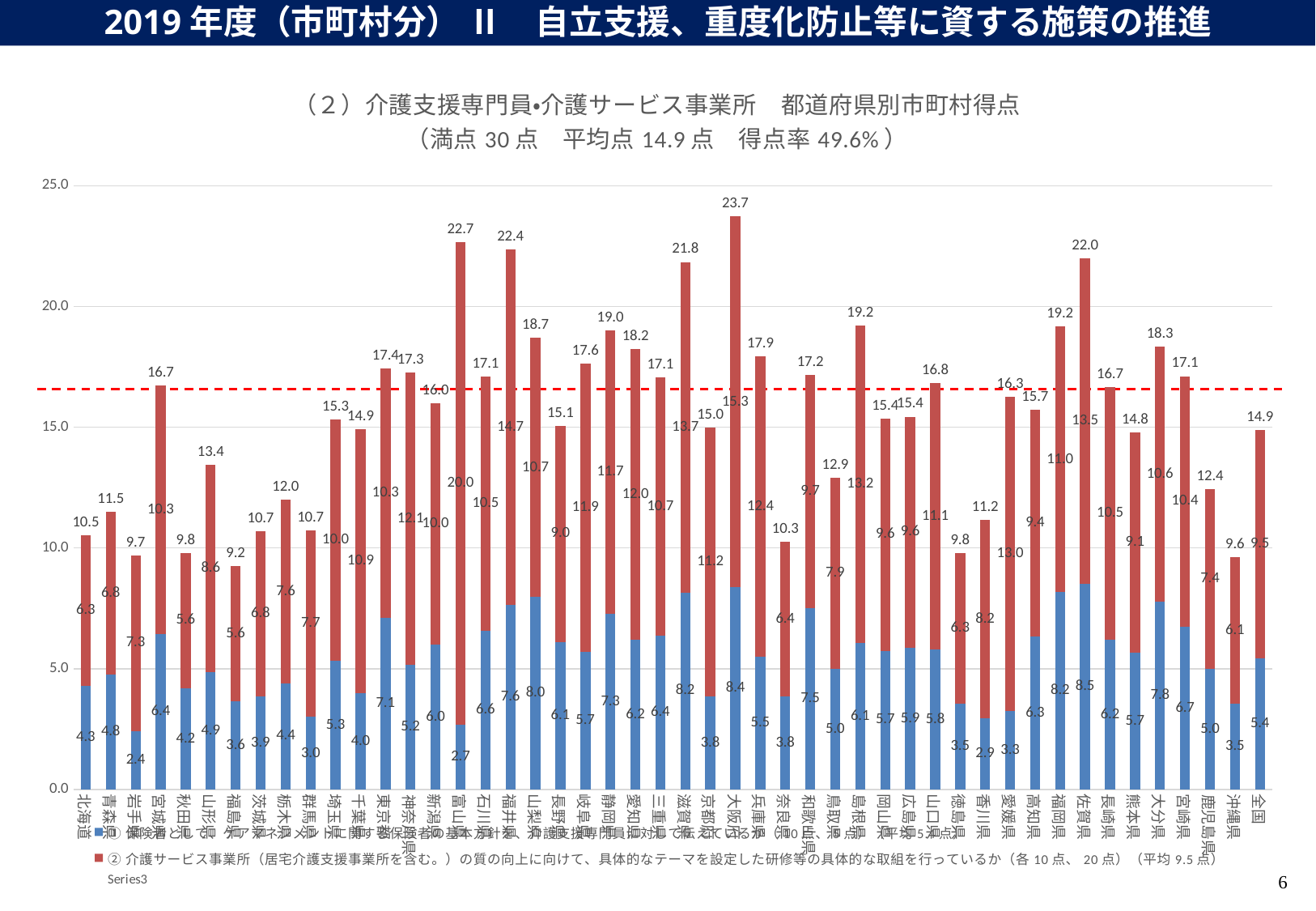
What is the sum of the two segments for 北海道 (4.3 and 6.3)? 10.6 Which has a higher total score, 滋賀県 or 福井県? 福井県 What average score (平均点) is stated in the chart title? 14.9 点 What is the total score labeled for 富山県? 22.7 What is the total score labeled for 全国? 14.9 Which prefecture has the highest total score in the chart? 大阪府 What kind of chart is shown on the slide? Stacked bar chart What is the difference between the total scores of 大阪府 and 福島県? 14.5 Is the total score for 奈良県 greater or less than 15.0? less What is the value of the blue (lower) segment for 佐賀県? 8.5 Which prefecture has the lowest total score in the chart? 福島県 What is the value of the red (upper) segment for 富山県? 20.0